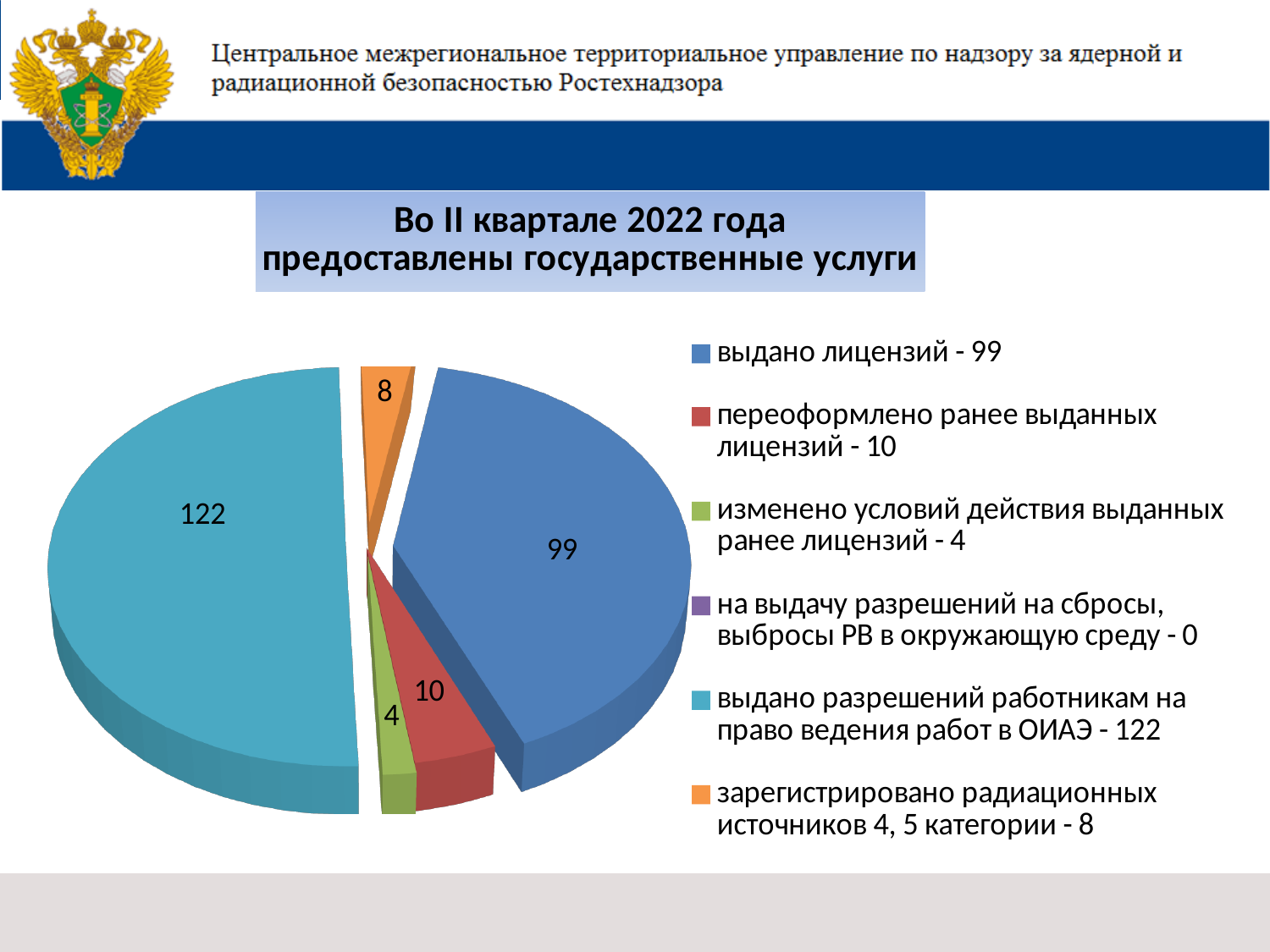
What is the difference between the number of permits issued to workers (122) and the number of licences issued (99)? 23 What is the value for 'выдано разрешений работникам на право ведения работ в ОИАЭ'? 122 What is the value for 'на выдачу разрешений на сбросы, выбросы РВ в окружающую среду'? 0 What is the value for 'изменено условий действия выданных ранее лицензий'? 4 What is the value for 'зарегистрировано радиационных источников 4, 5 категории'? 8 Which is larger: the number of re-issued licences or the number of registered radiation sources of categories 4 and 5? переоформлено ранее выданных лицензий How many licences were issued (выдано лицензий) according to the chart? 99 Which category has the largest slice of the pie? выдано разрешений работникам на право ведения работ в ОИАЭ How many entries does the chart legend list? 6 What is the value for 'переоформлено ранее выданных лицензий'? 10 What type of chart is shown on the slide? pie chart Which category has the smallest value in the legend? на выдачу разрешений на сбросы, выбросы РВ в окружающую среду